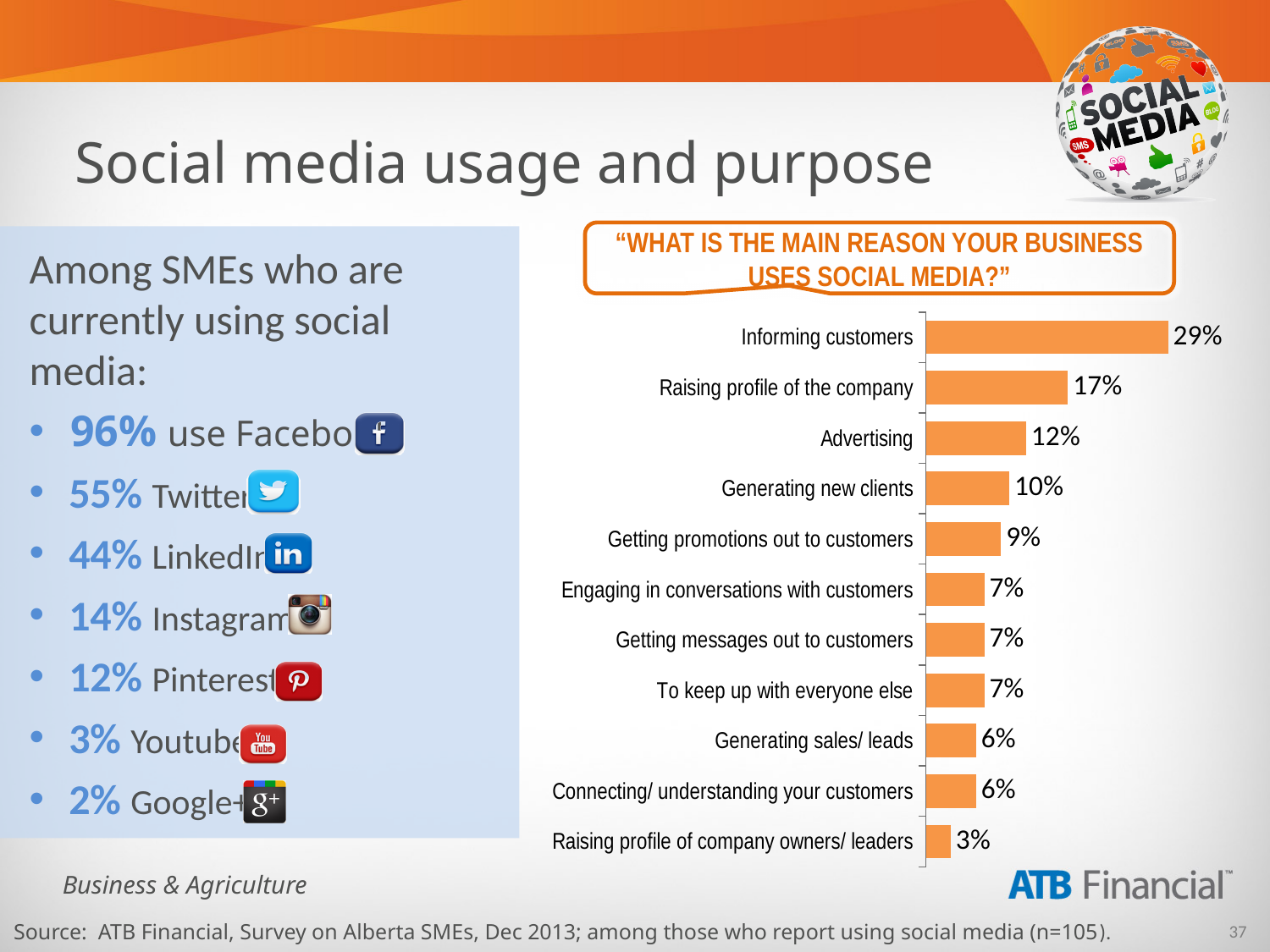
What is the difference in percentage points between "Informing customers" and "Raising profile of the company"? 12 What percentage of SMEs cite "Informing customers" as the main reason their business uses social media? 29% Which is larger: the value for "Getting promotions out to customers" or the value for "Generating sales/ leads"? Getting promotions out to customers What type of chart is used to show the main reasons businesses use social media? Bar chart What is the difference in percentage points between "Advertising" and "Raising profile of company owners/ leaders"? 9 What is the value shown for "Advertising" in the chart? 12% What is the value shown for "Generating new clients"? 10% What question is shown as the title above the bar chart? "What is the main reason your business uses social media?" Which reason has the lowest percentage in the chart? Raising profile of company owners/ leaders How many reasons (categories) are shown in the bar chart? 11 Which reason has the highest percentage in the chart? Informing customers How many categories in the chart have a value of 7%? 3